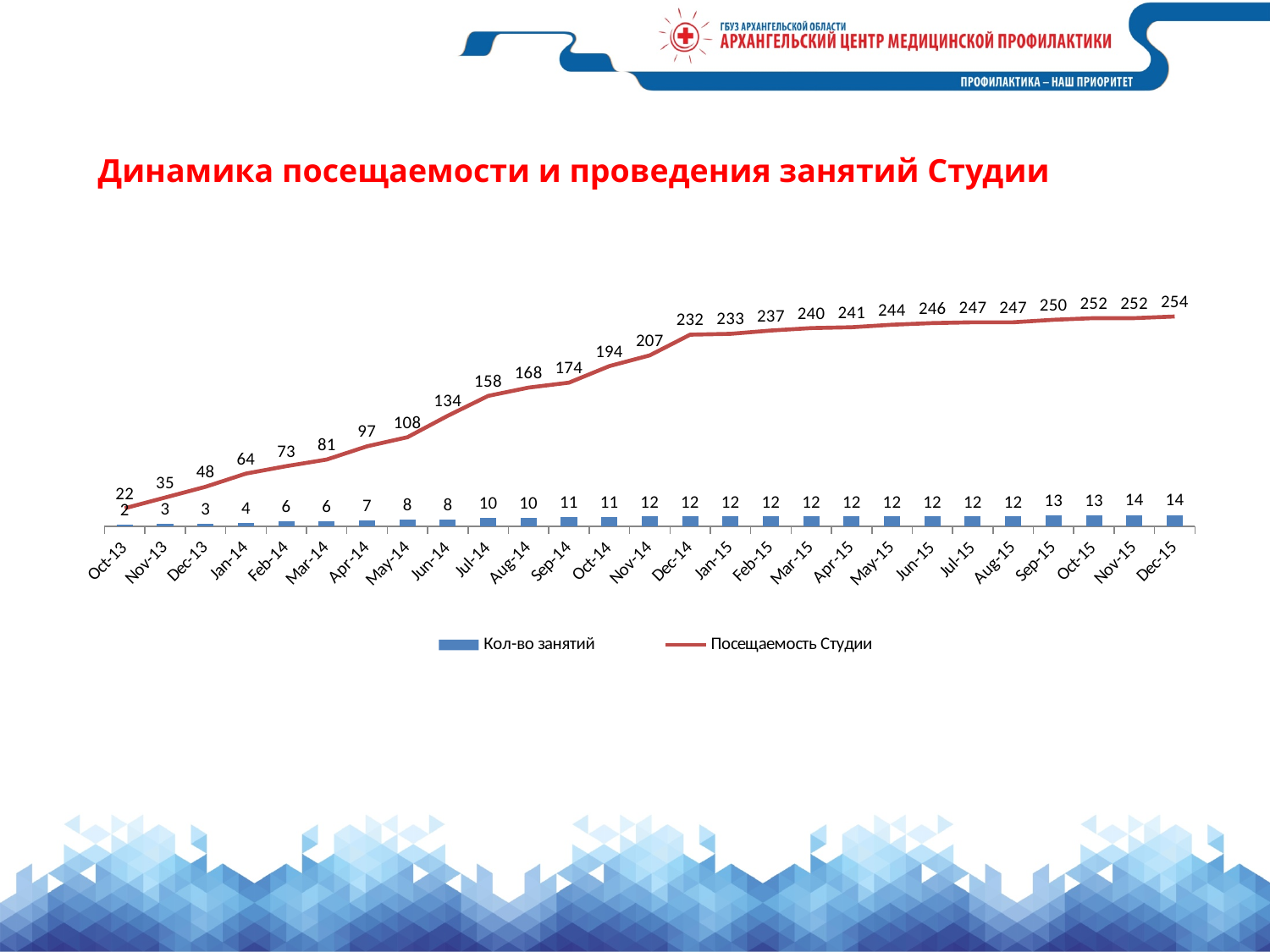
Which series is shown as a red line? Посещаемость Студии Does Посещаемость Студии rise or fall from Oct-13 to Dec-15? Rise What kind of chart is this? Combined bar and line chart Which is larger: Посещаемость Студии for Sep-14 or for Oct-14? Oct-14 Which month has the highest value of Кол-во занятий? Nov-15 and Dec-15 (tied at 14) What is the value of Посещаемость Студии for Jun-14? 134 What is the difference in Посещаемость Студии between Dec-14 and Nov-14? 25 How many months are shown on the x axis? 27 What is the value of Посещаемость Студии for Dec-15? 254 What is the value of Кол-во занятий for Jul-14? 10 Which month has the lowest value of Посещаемость Студии? Oct-13 How many series does the legend list? 2